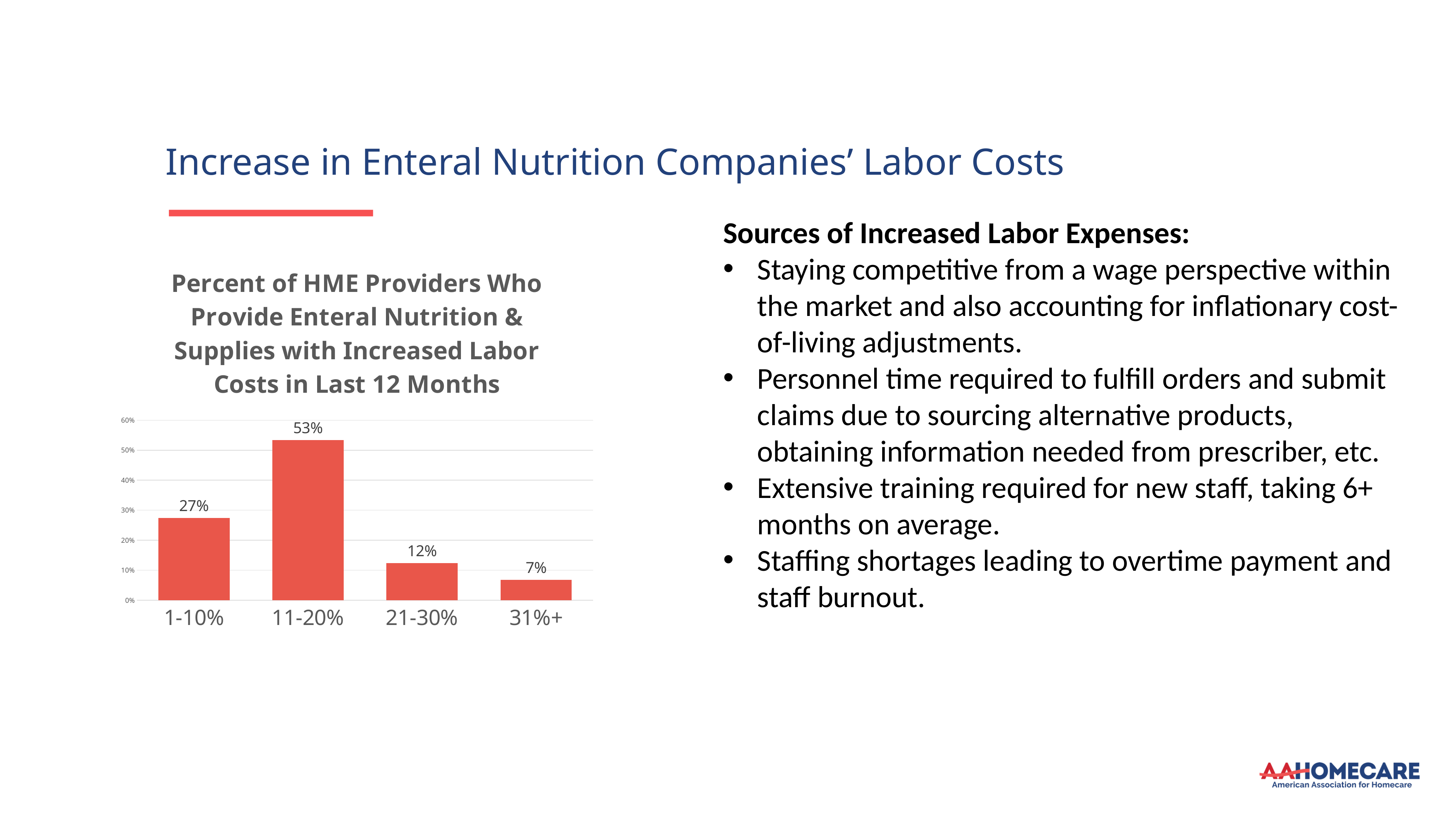
What is the title of the chart? Percent of HME Providers Who Provide Enteral Nutrition & Supplies with Increased Labor Costs in Last 12 Months What percentage of HME providers reported labor cost increases of 11-20%? 53% What is the difference between the values for 11-20% and 1-10%? 26% How many categories are shown on the x axis? 4 What is the value shown for the 21-30% category? 12% Which category has the highest value? 11-20% What is the value shown for the 31%+ category? 7% Which category has the lowest value? 31%+ What is the value shown for the 1-10% category? 27% Which is larger, the value for 21-30% or the value for 31%+? 21-30% Is the value for 11-20% greater or less than 50%? greater What kind of chart is shown on the slide? bar chart